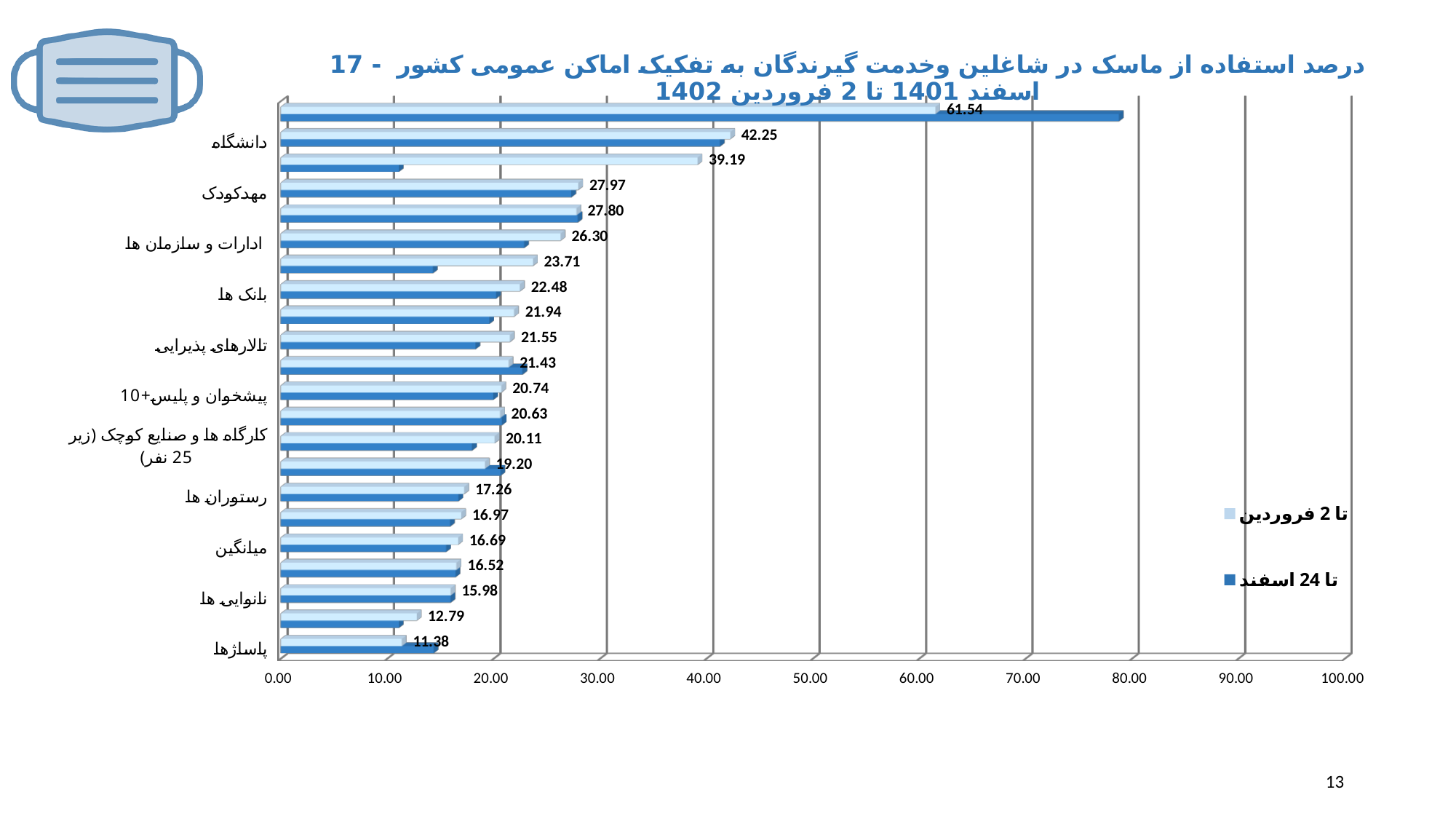
What is the difference between the two lowest data labels, 12.79 and 11.38? 1.41 What kind of chart is shown on the slide? bar chart What are the two legend entries of the chart? تا 2 فروردین and تا 24 اسفند What is the difference between the two highest data labels, 61.54 and 42.25? 19.29 How many data labels are printed on the chart? 22 What is the highest data label shown for the تا 2 فروردین series? 61.54 What is the value labelled for میانگین in the تا 2 فروردین series? 16.69 How many series does the legend list? 2 Is the تا 24 اسفند value for the topmost category greater or less than 70.00? greater For the topmost category, which series has the larger bar, تا 2 فروردین or تا 24 اسفند? تا 24 اسفند What is the value labelled for پاساژها in the تا 2 فروردین series? 11.38 What is the lowest data label shown for the تا 2 فروردین series? 11.38